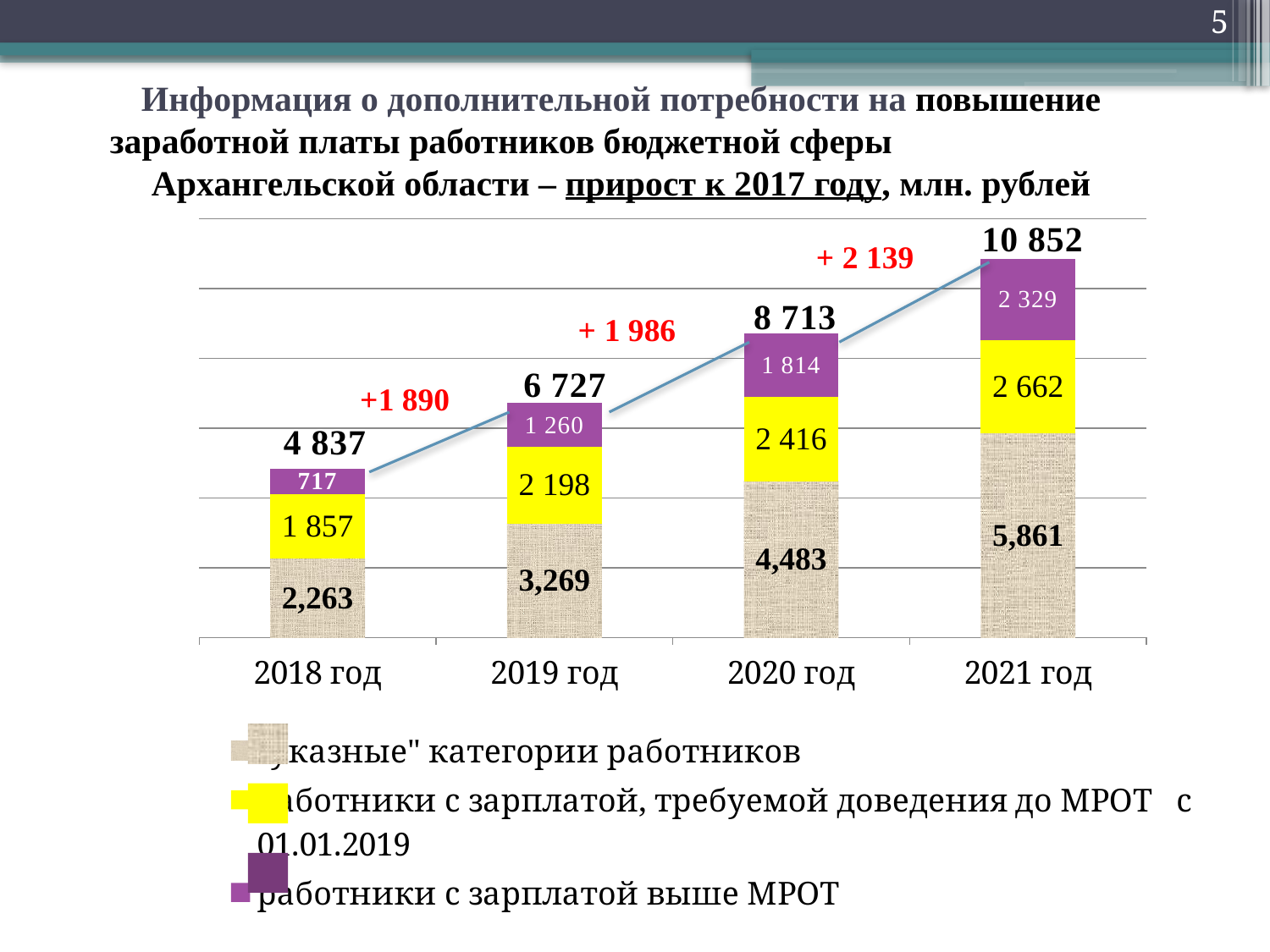
Which year has the lowest total value? 2018 год What is the total value of the stacked bar for 2018 год? 4 837 What is the increase in total from 2019 год to 2020 год, as labelled on the chart? + 1 986 What is the value of the bottom (textured) segment for 2021 год? 5,861 What type of chart is shown on the slide? stacked bar chart What is the value of the purple segment (работники с зарплатой выше МРОТ) for 2020 год? 1 814 Do the total values rise or fall from 2018 год to 2021 год? rise What is the total value of the stacked bar for 2021 год? 10 852 What is the value of the yellow segment for 2019 год? 2 198 Which year has the highest total value? 2021 год How many series does the legend list? 3 How many years (categories) are shown on the x axis? 4